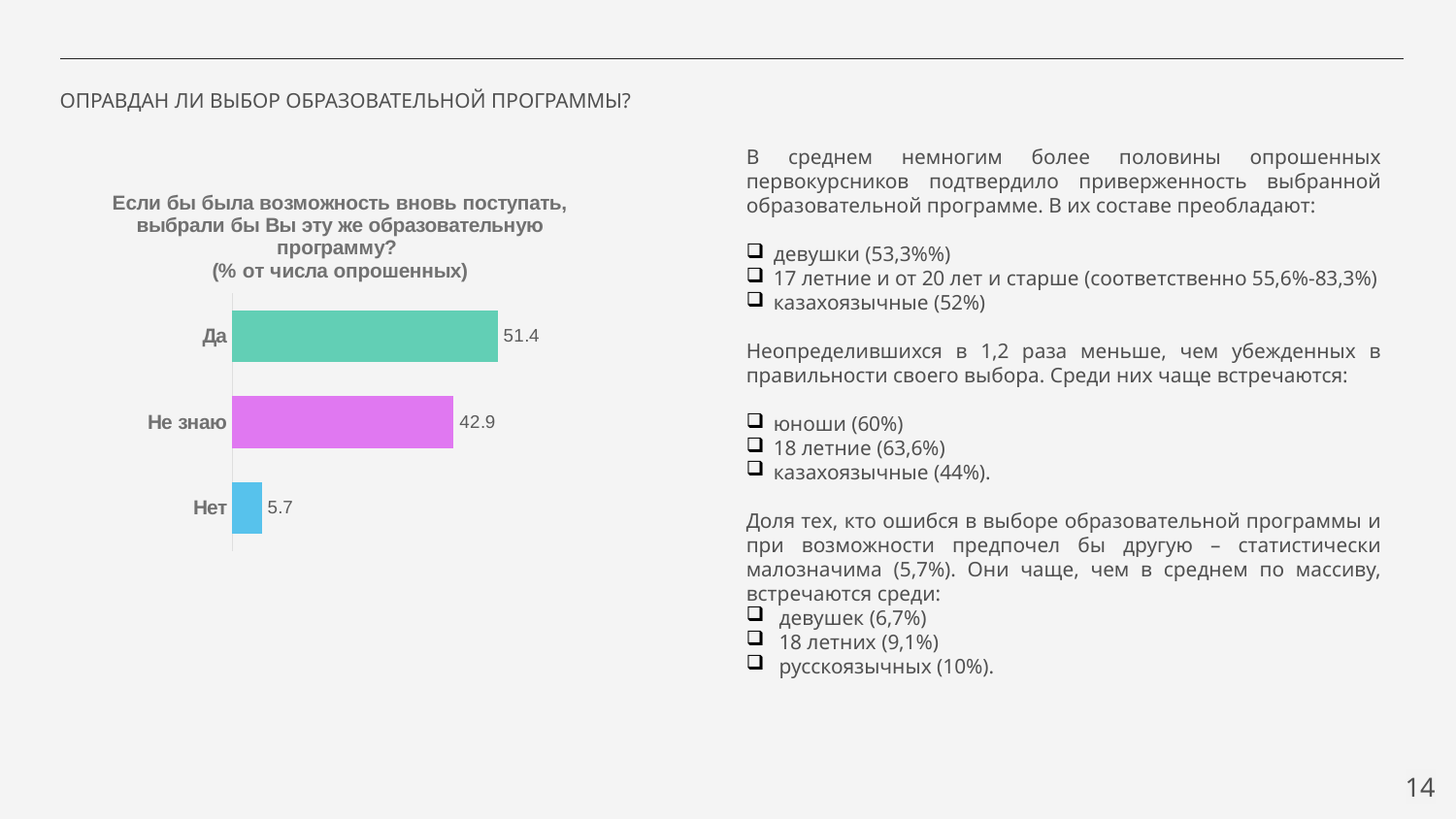
What is the value for "Нет" in the chart? 5.7 What kind of chart is shown on the slide? Bar chart Which is larger, the value for "Да" or the value for "Не знаю"? Да What is the difference between the values for "Не знаю" and "Нет"? 37.2 What is the title of the chart? Если бы была возможность вновь поступать, выбрали бы Вы эту же образовательную программу? (% от числа опрошенных) What is the difference between the values for "Да" and "Не знаю"? 8.5 What colour is the bar for "Не знаю"? Purple Which category has the highest value in the chart? Да What is the value for "Не знаю" in the chart? 42.9 What is the value for "Да" in the chart? 51.4 Which category has the lowest value in the chart? Нет How many categories are shown in the chart? 3